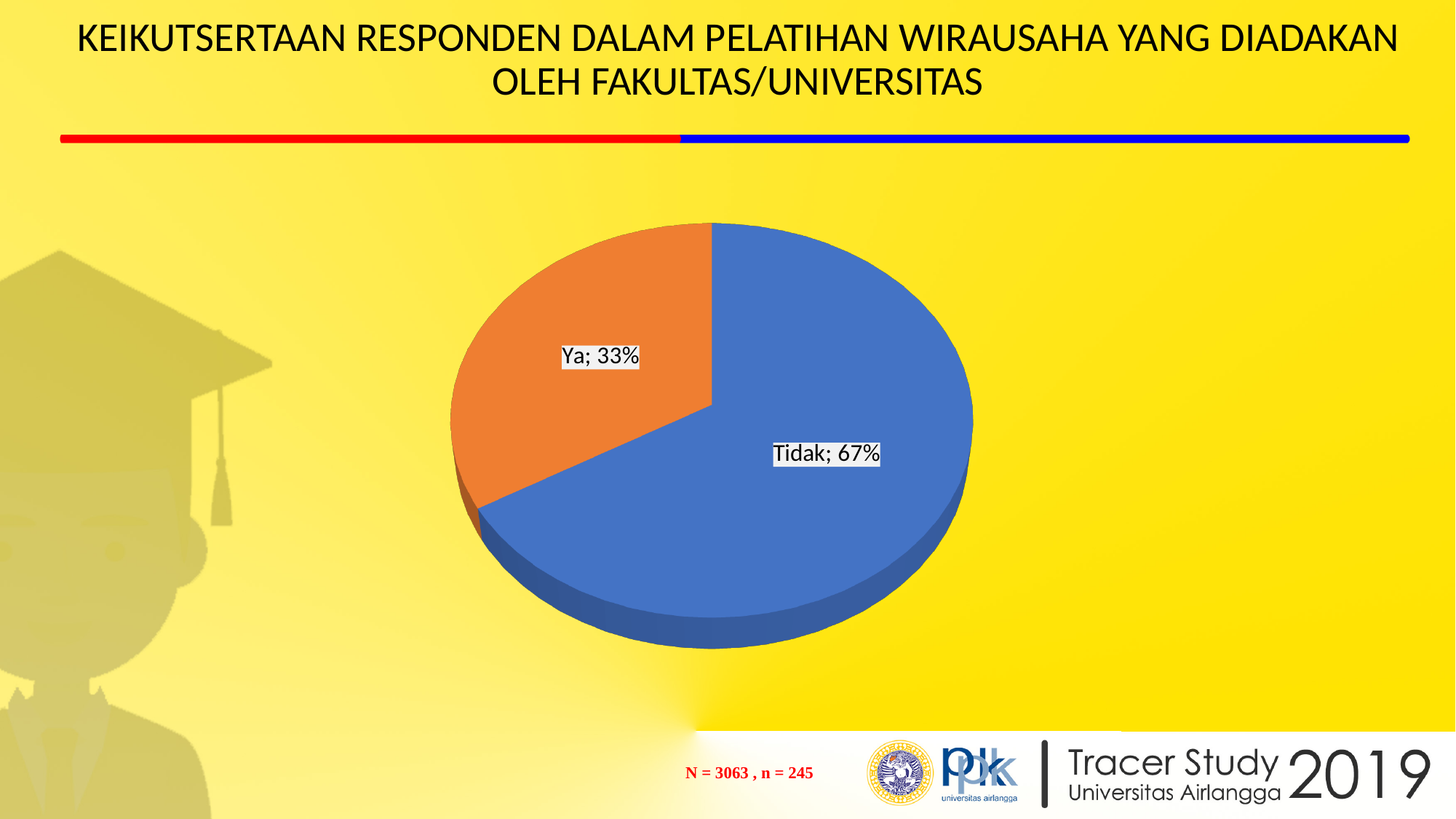
What percentage of respondents answered "Tidak"? 67% What kind of chart is shown on the slide? Pie chart What is the difference in percentage points between "Tidak" and "Ya"? 34 Which is larger, the share for "Ya" or the share for "Tidak"? Tidak What colour is the "Tidak" slice? Blue Which category has the smallest share of the pie? Ya What colour is the "Ya" slice? Orange How many slices does the pie chart have? 2 What percentage of respondents answered "Ya"? 33% What share of the pie does the "Ya" slice represent? 33% Which category has the largest share of the pie? Tidak